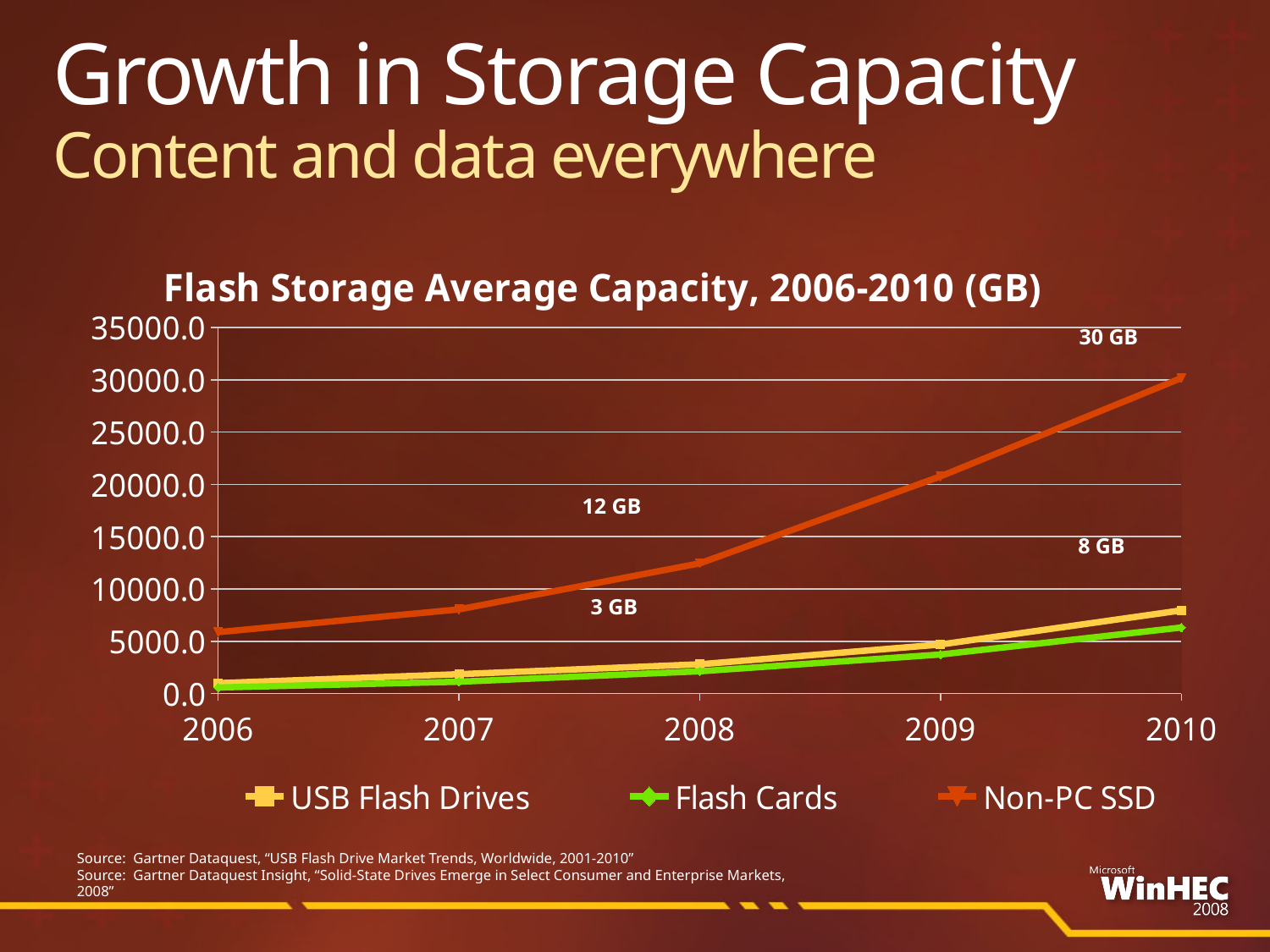
Is the value for USB Flash Drives in 2010 greater or less than 10000.0? less Is the value for Non-PC SSD in 2008 greater or less than 10000.0? greater How many series does the chart legend list? 3 How many years are shown along the x axis of the chart? 5 What capacity label is printed next to the Non-PC SSD line at 2010? 30 GB Which series has the lowest value in 2010? Flash Cards What kind of chart is shown on the slide? line chart Is the value for Non-PC SSD in 2010 greater or less than 25000.0? greater In 2010, which is larger: USB Flash Drives or Flash Cards? USB Flash Drives Does the Non-PC SSD line rise or fall from 2006 to 2010? rise What is the title of the chart? Flash Storage Average Capacity, 2006-2010 (GB) Which series has the highest value in 2010? Non-PC SSD